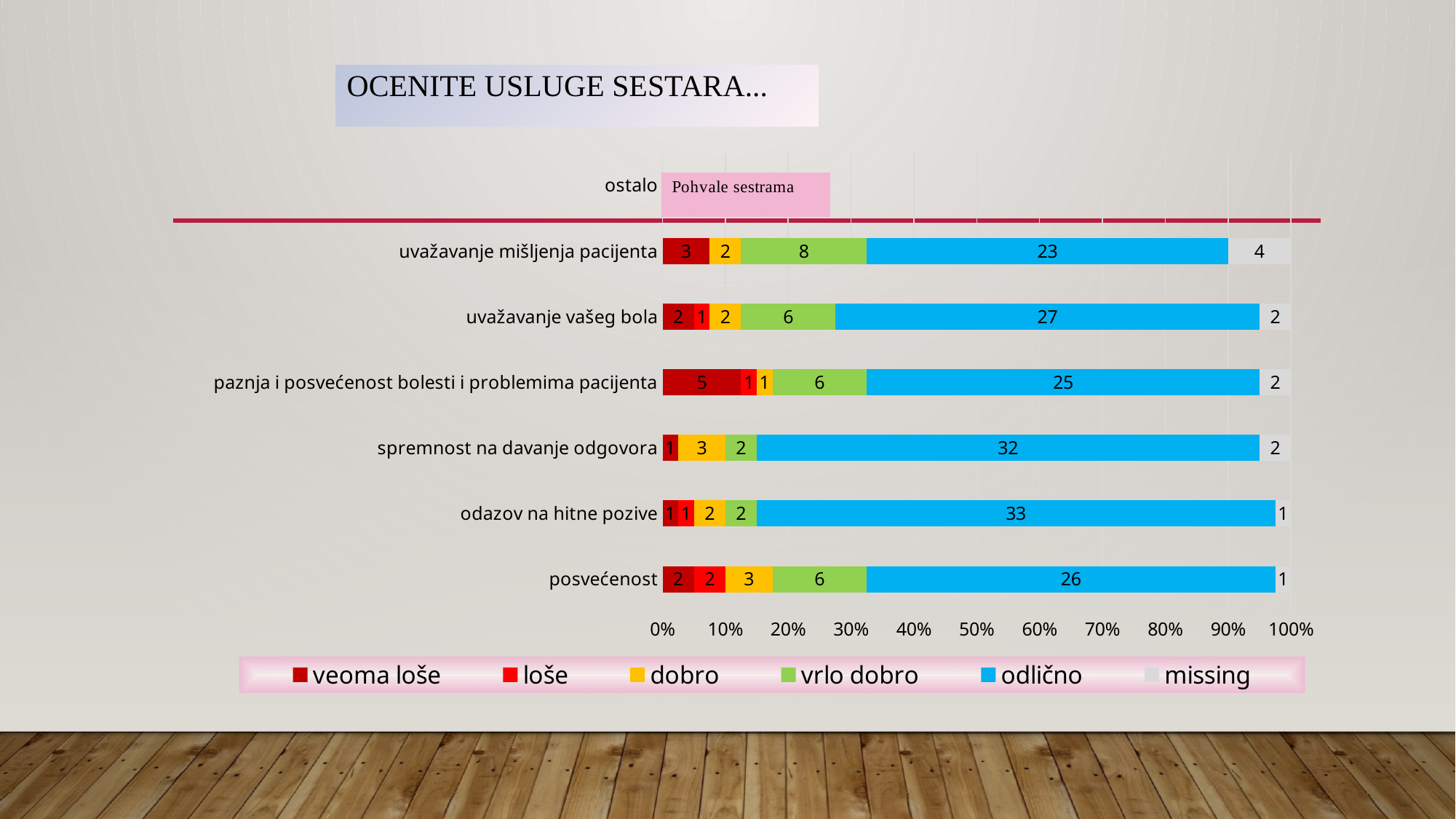
Which is larger: the 'veoma loše' value for 'paznja i posvećenost bolesti i problemima pacijenta' or for 'uvažavanje mišljenja pacijenta'? paznja i posvećenost bolesti i problemima pacijenta What is the 'odlično' value for 'odazov na hitne pozive'? 33 What is the 'vrlo dobro' value for 'uvažavanje mišljenja pacijenta'? 8 What is the 'missing' value for 'uvažavanje mišljenja pacijenta'? 4 What is the 'veoma loše' value for 'paznja i posvećenost bolesti i problemima pacijenta'? 5 What is the total of all segments in the 'posvećenost' bar? 40 How many series does the legend list? 6 What is the difference between the 'odlično' values for 'spremnost na davanje odgovora' and 'posvećenost'? 6 What is the 'dobro' value for 'spremnost na davanje odgovora'? 3 What kind of chart is shown on the slide? stacked bar chart Which category has the lowest 'odlično' value? uvažavanje mišljenja pacijenta Which category has the highest 'odlično' value? odazov na hitne pozive